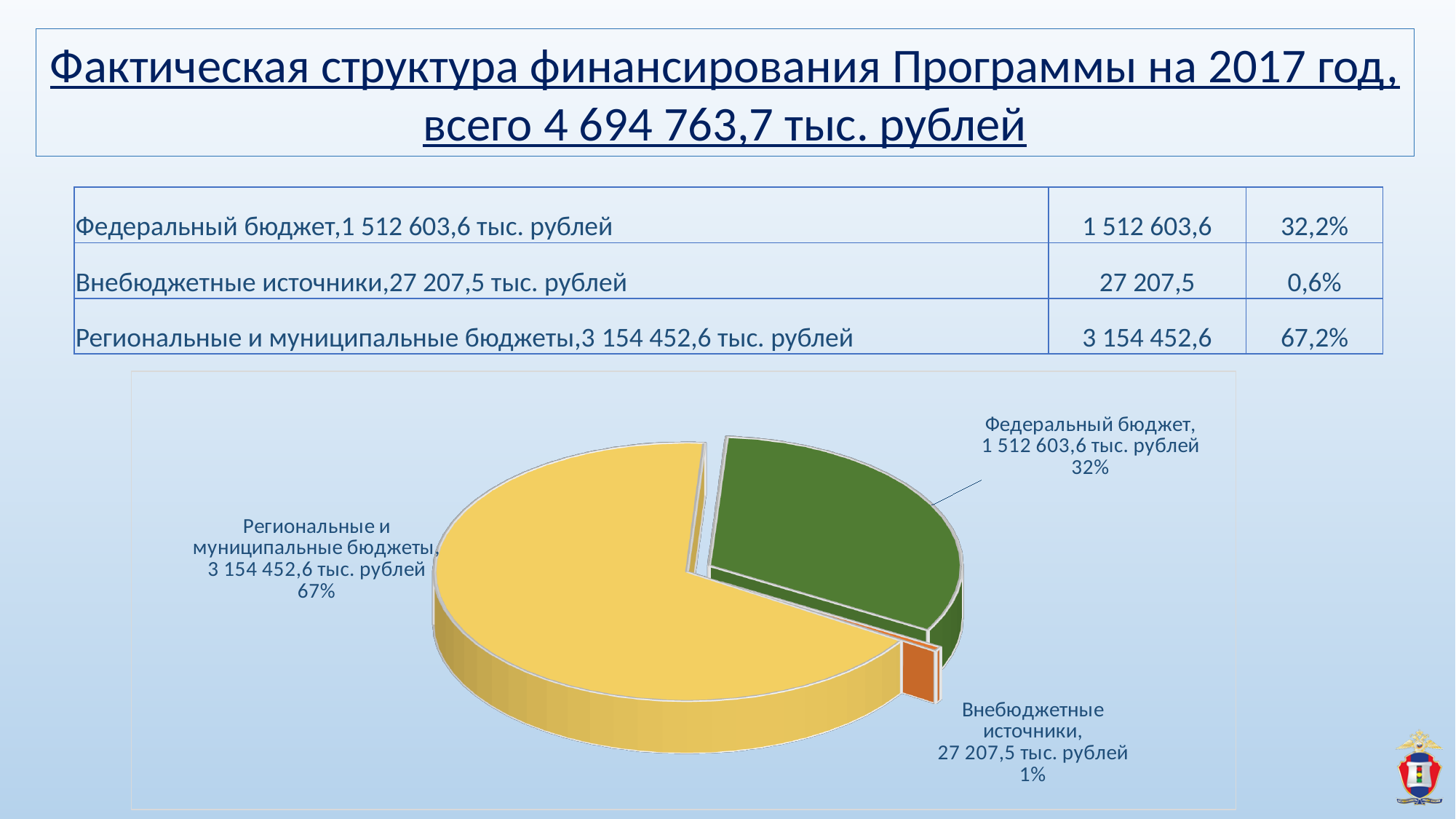
What value is shown for Федеральный бюджет in the pie chart? 1 512 603,6 тыс. рублей Which category has the largest slice of the pie chart? Региональные и муниципальные бюджеты What kind of chart is shown on the slide? Pie chart How many slices does the pie chart have? 3 Which category has the smallest slice of the pie chart? Внебюджетные источники What value is shown for Внебюджетные источники in the pie chart? 27 207,5 тыс. рублей What share of the pie does Внебюджетные источники represent? 1% What colour is the slice for Федеральный бюджет? Green What share of the pie does Региональные и муниципальные бюджеты represent? 67% What is the difference between the values for Региональные и муниципальные бюджеты and Федеральный бюджет? 1 641 849,0 тыс. рублей What share of the pie does Федеральный бюджет represent? 32% Which is larger in the pie chart: Федеральный бюджет or Внебюджетные источники? Федеральный бюджет